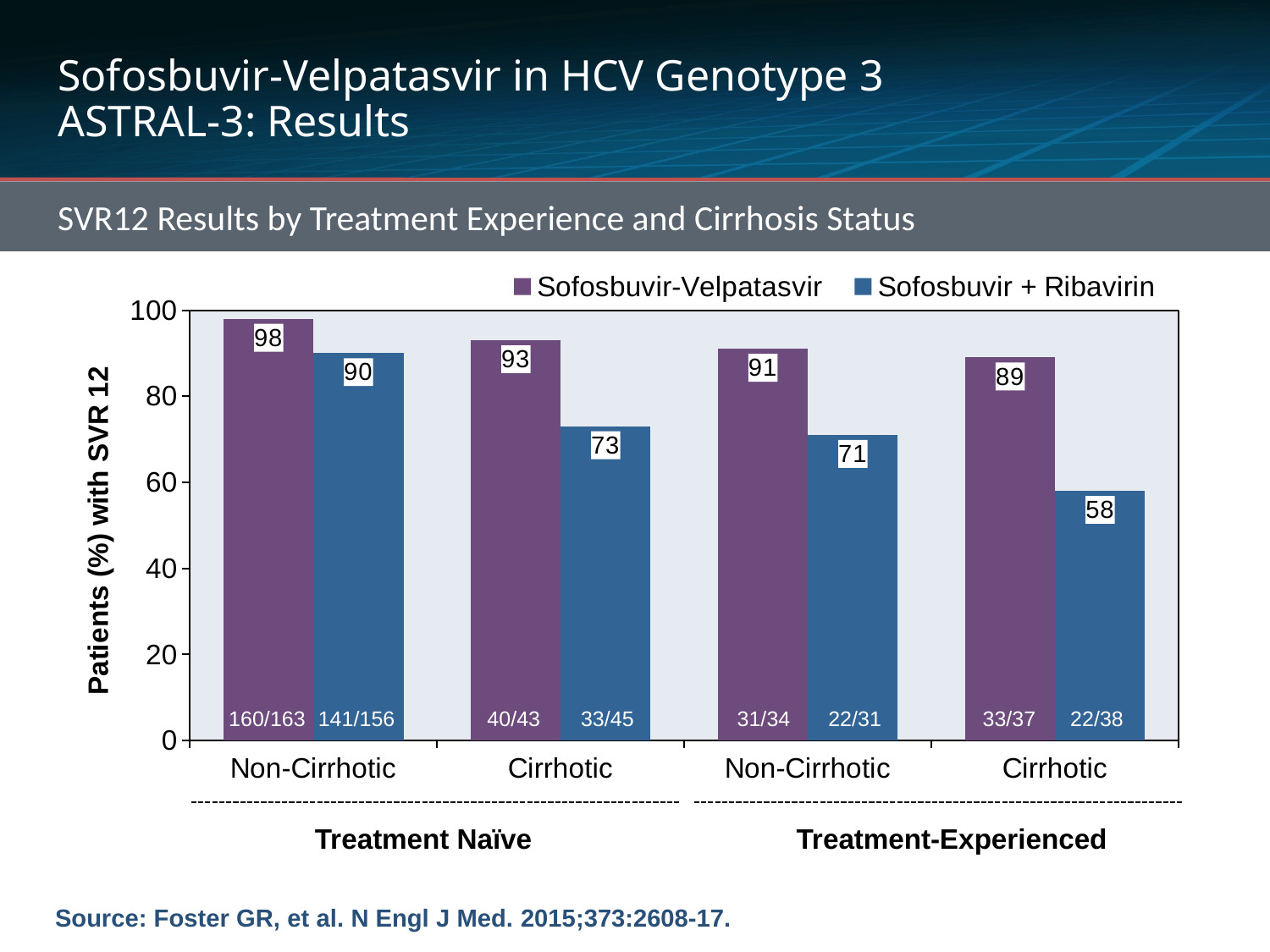
Which treatment has the higher SVR12 rate in treatment-experienced non-cirrhotic patients? Sofosbuvir-Velpatasvir How many patient groups are shown along the x axis? 4 What is the difference between the Sofosbuvir-Velpatasvir and Sofosbuvir + Ribavirin SVR12 rates in treatment-naïve non-cirrhotic patients? 8 What is the SVR12 rate for Sofosbuvir-Velpatasvir in treatment-naïve non-cirrhotic patients? 98 What kind of chart is shown on the slide? Bar chart Which group has the highest SVR12 rate for Sofosbuvir-Velpatasvir? Treatment Naïve Non-Cirrhotic What is the difference between the Sofosbuvir-Velpatasvir and Sofosbuvir + Ribavirin SVR12 rates in treatment-experienced cirrhotic patients? 31 What is the SVR12 rate for Sofosbuvir + Ribavirin in treatment-naïve cirrhotic patients? 73 Which group has the lowest SVR12 rate for Sofosbuvir + Ribavirin? Treatment-Experienced Cirrhotic What is the SVR12 rate for Sofosbuvir + Ribavirin in treatment-experienced cirrhotic patients? 58 How many series does the legend list? 2 What is the label of the y axis? Patients (%) with SVR 12